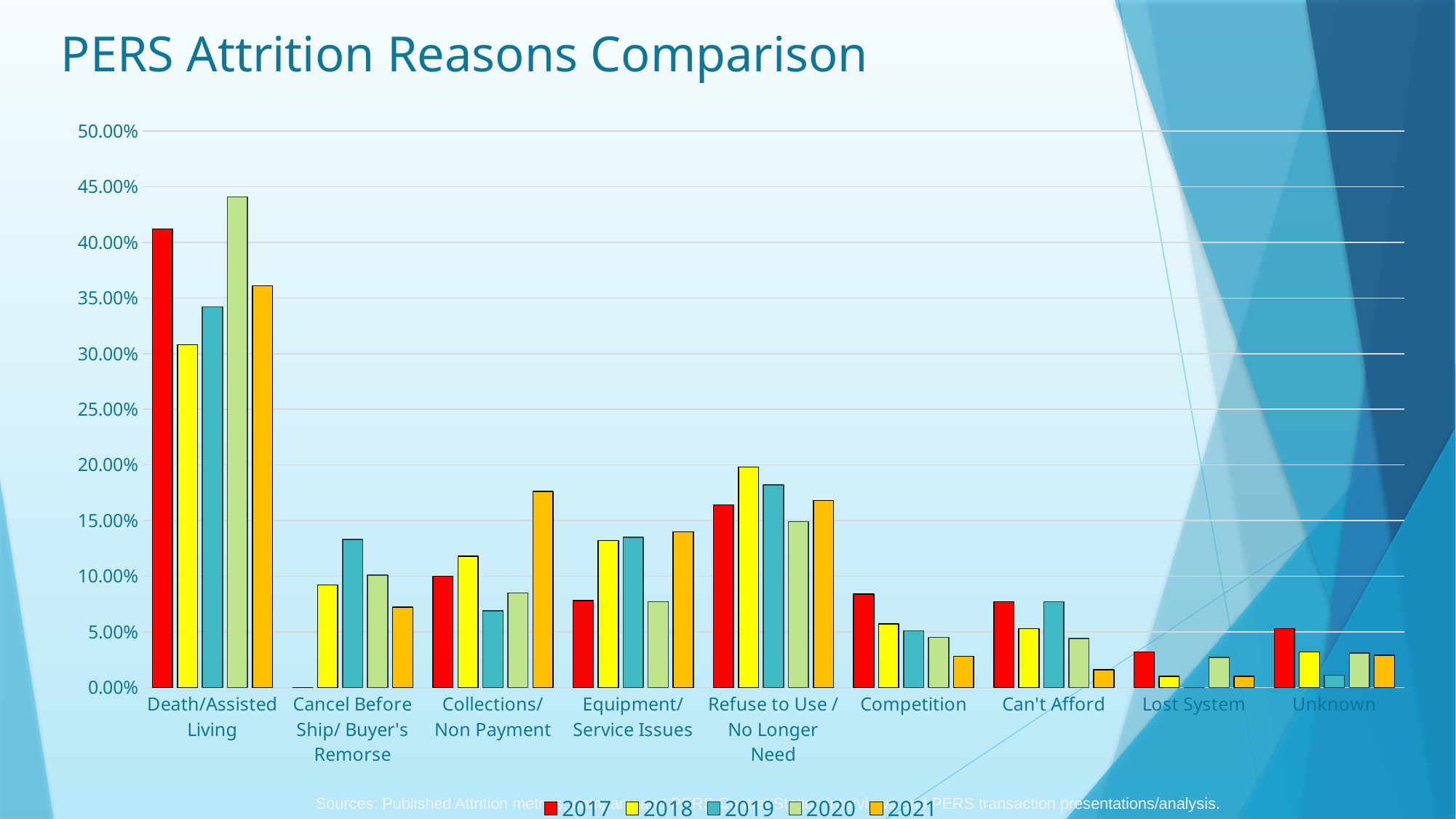
Is the 2018 value for Lost System greater or less than 5.00%? less What kind of chart is shown on the slide? bar chart How many attrition reason categories are shown on the x axis? 9 Which category has the highest 2020 value? Death/Assisted Living How many series does the legend list? 5 What is the title of the chart? PERS Attrition Reasons Comparison Which year has the lowest bar for Cancel Before Ship/ Buyer's Remorse? 2017 Is the 2019 value for Death/Assisted Living greater or less than 30.00%? greater Is the 2021 value for Collections/ Non Payment greater or less than 15.00%? greater For Competition, do the values rise or fall from 2017 to 2021? fall Which year has the tallest bar for Death/Assisted Living? 2020 For Refuse to Use / No Longer Need, which is larger: the 2018 value or the 2020 value? 2018